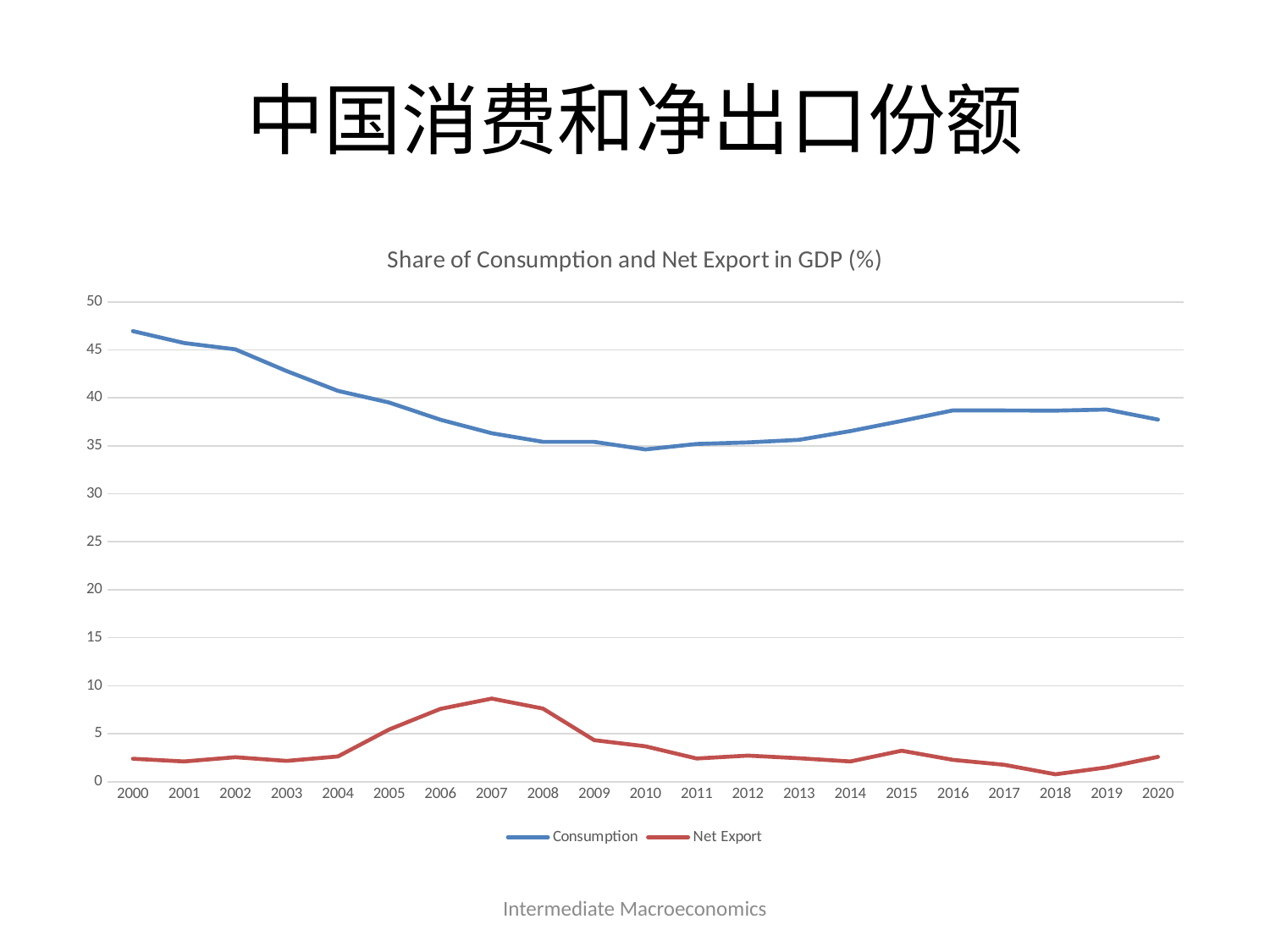
What kind of chart is shown on the slide? Line chart Which is larger, the Consumption value in 2000 or in 2020? 2000 Does the Consumption series rise or fall between 2000 and 2010? Fall How many years are plotted along the x axis? 21 How many series does the legend list? 2 In which year is the Net Export series at its lowest? 2018 Is the Net Export value for 2007 greater or less than 5? greater In which year does the Net Export series reach its peak? 2007 Is the Consumption value for 2000 greater or less than 45? greater In which year is the Consumption series at its lowest? 2010 What are the two series named in the legend? Consumption and Net Export In which year is the Consumption series at its highest? 2000